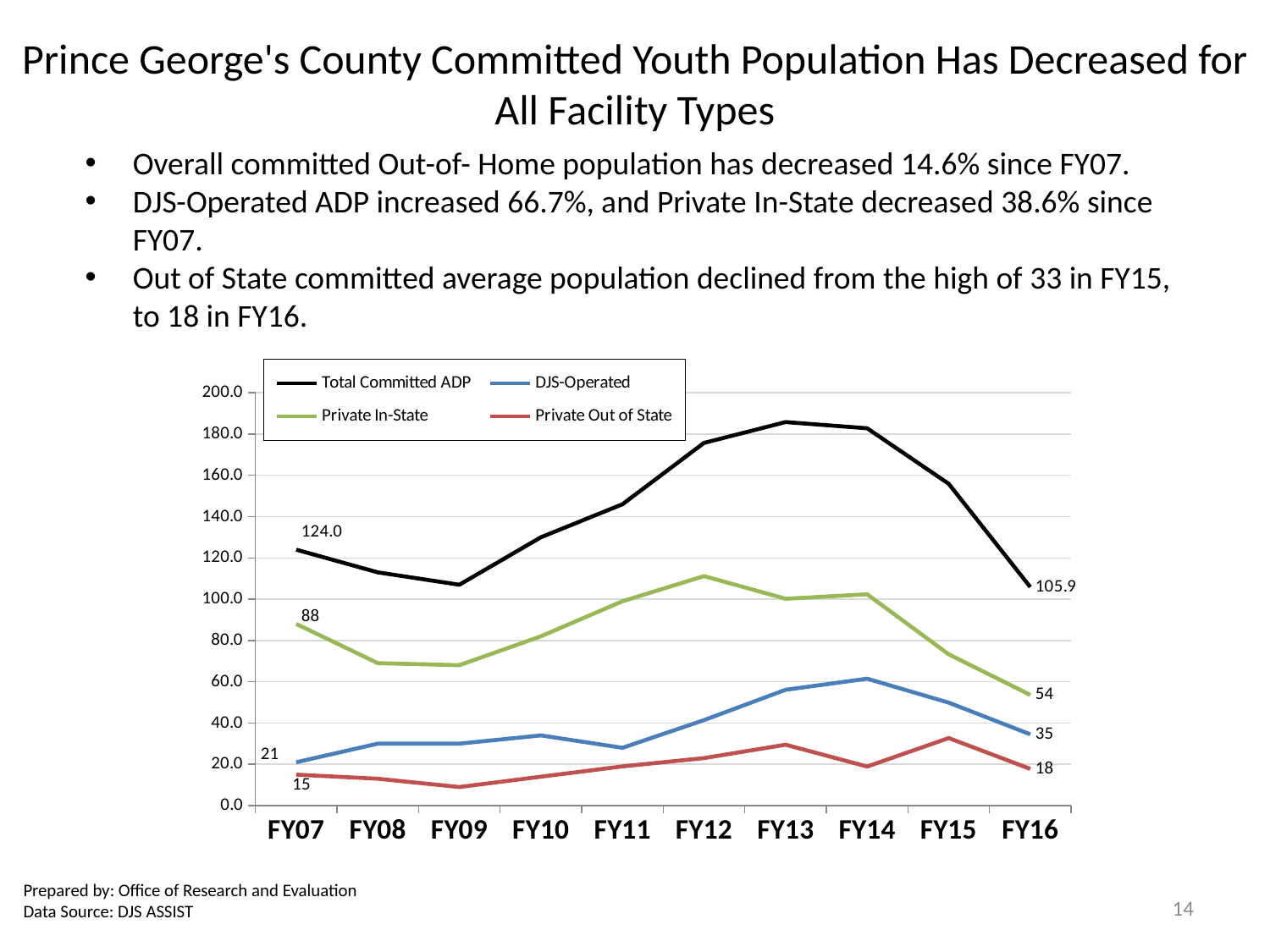
What is the difference between the Total Committed ADP in FY07 (124.0) and in FY16 (105.9)? 18.1 How many series does the chart legend list? 4 By how much did the Private In-State value decrease from FY07 (88) to FY16 (54)? 34 What is the Total Committed ADP value in FY16? 105.9 How many fiscal years are plotted along the x axis? 10 Is the Total Committed ADP value in FY13 greater or less than 180? greater What is the Total Committed ADP value in FY07? 124.0 In FY16, which is larger: the DJS-Operated value or the Private Out of State value? DJS-Operated What is the Private In-State value in FY07? 88 What type of chart is shown on the slide? line chart In which fiscal year is the Private Out of State line at its lowest? FY09 What is the DJS-Operated value in FY16? 35